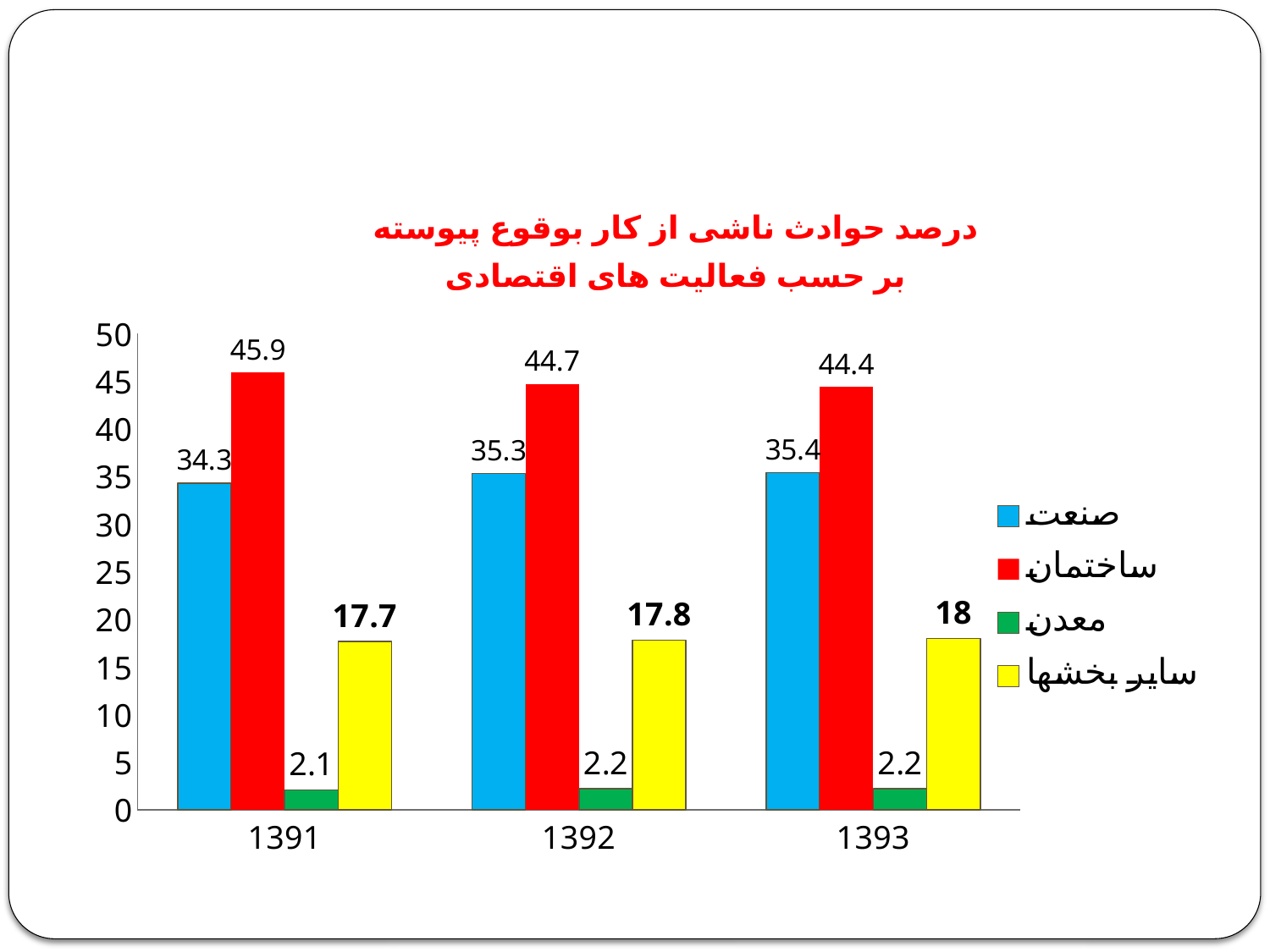
What is the difference between the ساختمان and صنعت values in 1392? 9.4 Which series has the lowest value in 1393? معدن What kind of chart is shown on the slide? bar chart Do the values for ساختمان rise or fall from 1391 to 1393? fall What is the value for معدن in 1391? 2.1 How many series does the legend list? 4 What is the value for سایر بخشها in 1392? 17.8 What is the value for صنعت in 1393? 35.4 What is the value for ساختمان in 1391? 45.9 How many years are shown on the x axis? 3 In which year is the value for ساختمان highest? 1391 Which is larger: the value for سایر بخشها in 1393 or in 1391? 1393